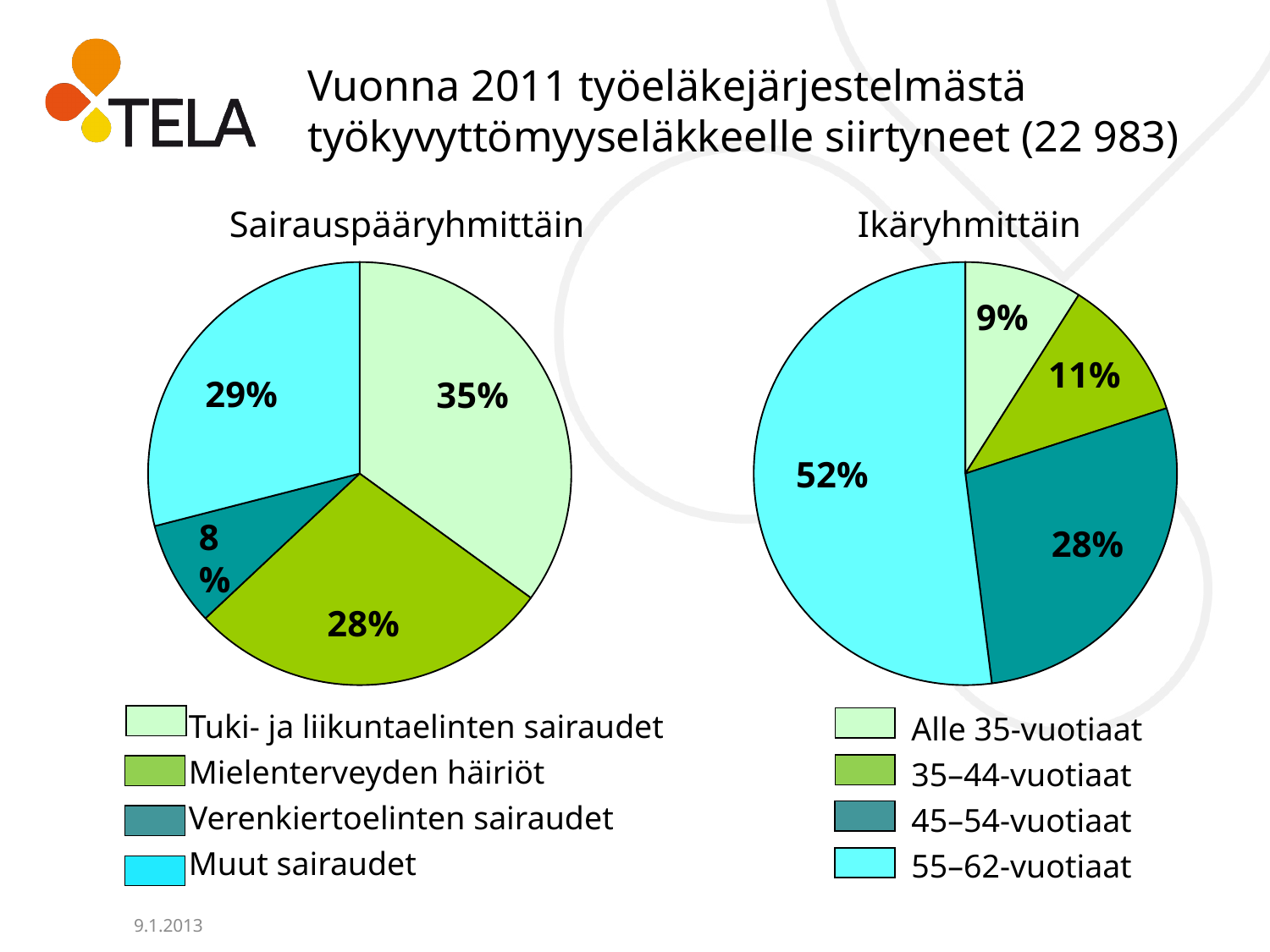
In the 'Sairauspääryhmittäin' chart, which category has the smallest share? Verenkiertoelinten sairaudet In the 'Ikäryhmittäin' chart, what is the difference in percentage points between 55–62-vuotiaat and 45–54-vuotiaat? 24 percentage points How many categories does the 'Ikäryhmittäin' chart show? 4 In the 'Sairauspääryhmittäin' chart, what share is Tuki- ja liikuntaelinten sairaudet? 35% What type of chart is the 'Sairauspääryhmittäin' chart? Pie chart In the 'Sairauspääryhmittäin' chart, what share is Verenkiertoelinten sairaudet? 8% In the 'Sairauspääryhmittäin' chart, which category has the largest share? Tuki- ja liikuntaelinten sairaudet In the 'Sairauspääryhmittäin' chart, what is the difference in percentage points between Muut sairaudet and Mielenterveyden häiriöt? 1 percentage point In the 'Ikäryhmittäin' chart, which is larger: 45–54-vuotiaat or 35–44-vuotiaat? 45–54-vuotiaat In the 'Ikäryhmittäin' chart, which age group has the smallest share? Alle 35-vuotiaat In the 'Ikäryhmittäin' chart, what share is 35–44-vuotiaat? 11% In the 'Ikäryhmittäin' chart, what share is 55–62-vuotiaat? 52%